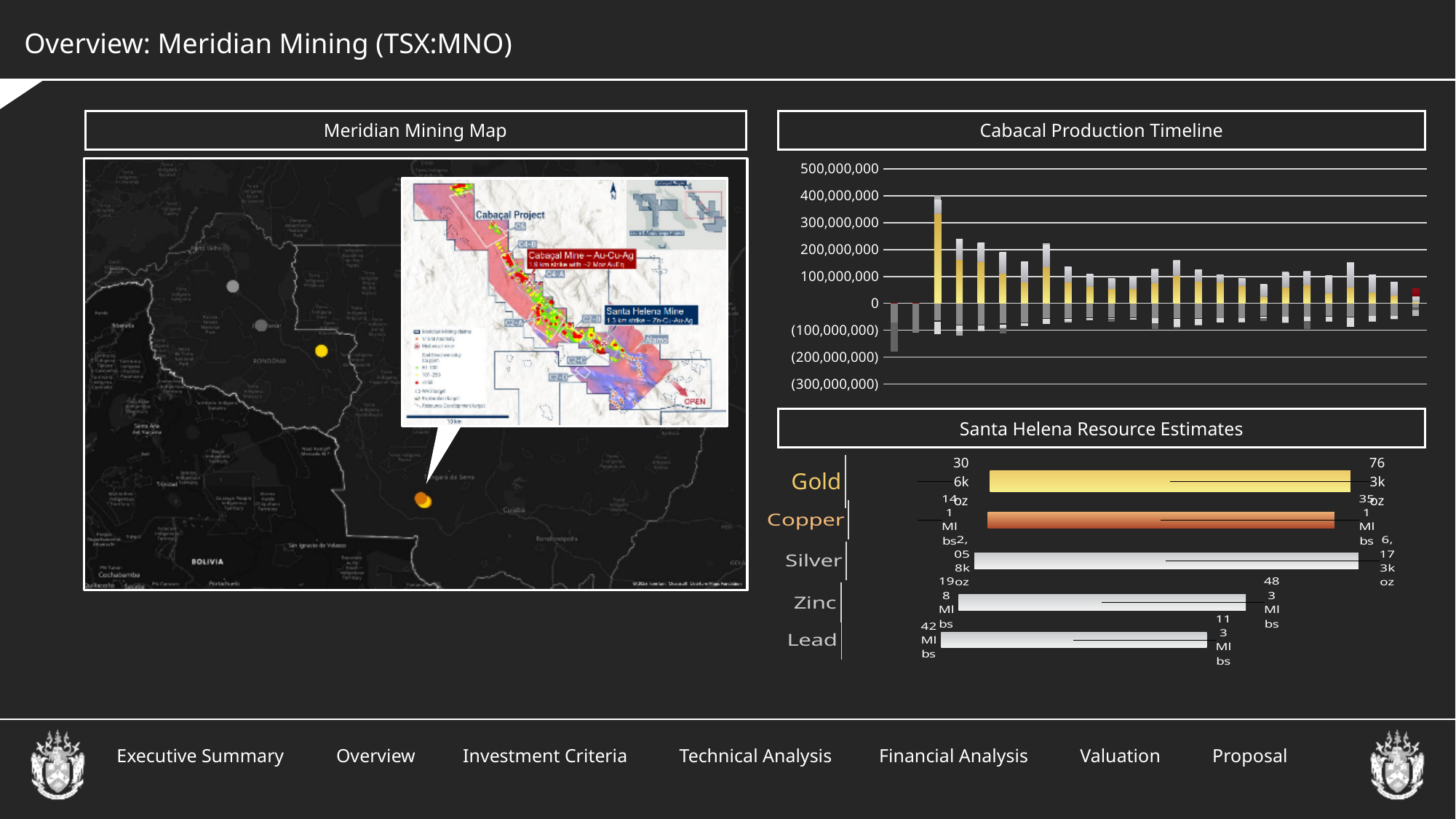
How many categories are shown in the Santa Helena Resource Estimates chart? 5 On the Cabacal Production Timeline, is the tallest bar greater or less than 300,000,000? greater What kind of chart is the Cabacal Production Timeline? bar chart In the Santa Helena Resource Estimates chart, which category has the shortest bar? Lead In the Santa Helena Resource Estimates chart, which bar is longer, Gold or Lead? Gold In the Santa Helena Resource Estimates chart, what colour is the Copper bar? orange In the Santa Helena Resource Estimates chart, which bar is longer, Zinc or Lead? Zinc What kind of chart is the Santa Helena Resource Estimates chart? bar chart On the Cabacal Production Timeline, what is the highest value shown on the vertical axis? 500,000,000 On the Cabacal Production Timeline, is the value of the first bar greater or less than 0? less